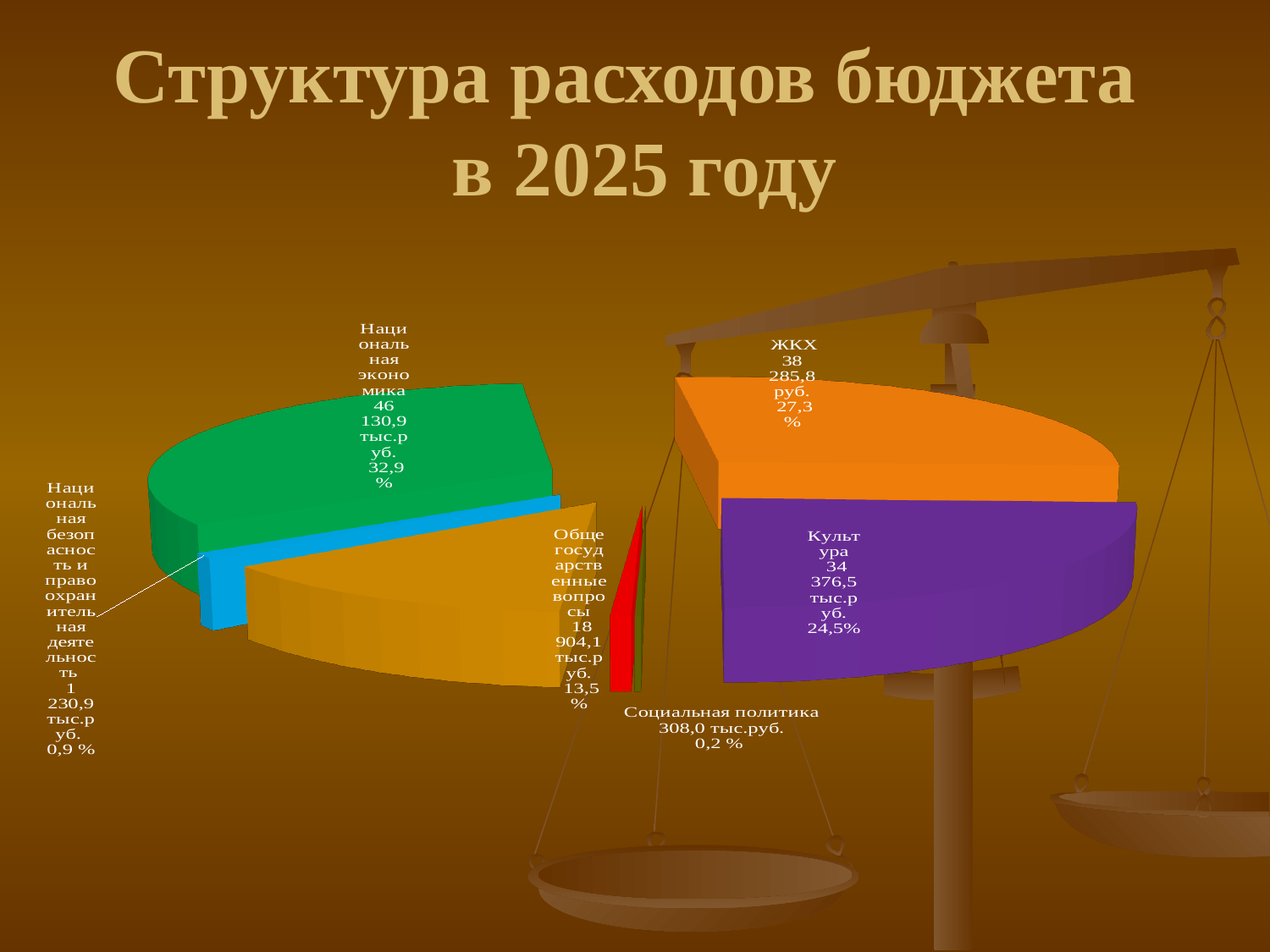
What is the value shown for ЖКХ? 38 285,8 руб. What is the title of the chart on the slide? Структура расходов бюджета в 2025 году What kind of chart is shown on the slide? pie chart What is the difference in percentage points between the shares of Национальная экономика and Общегосударственные вопросы? 19,4 What percentage share does Культура have? 24,5% Which category has the smallest share of the pie? Социальная политика What percentage share does Национальная экономика have? 32,9 % What is the value shown for Социальная политика? 308,0 тыс.руб. What is the value shown for Общегосударственные вопросы? 18 904,1 тыс.руб. Which category has the largest share of the pie? Национальная экономика Which is larger, the share for ЖКХ or the share for Культура? ЖКХ